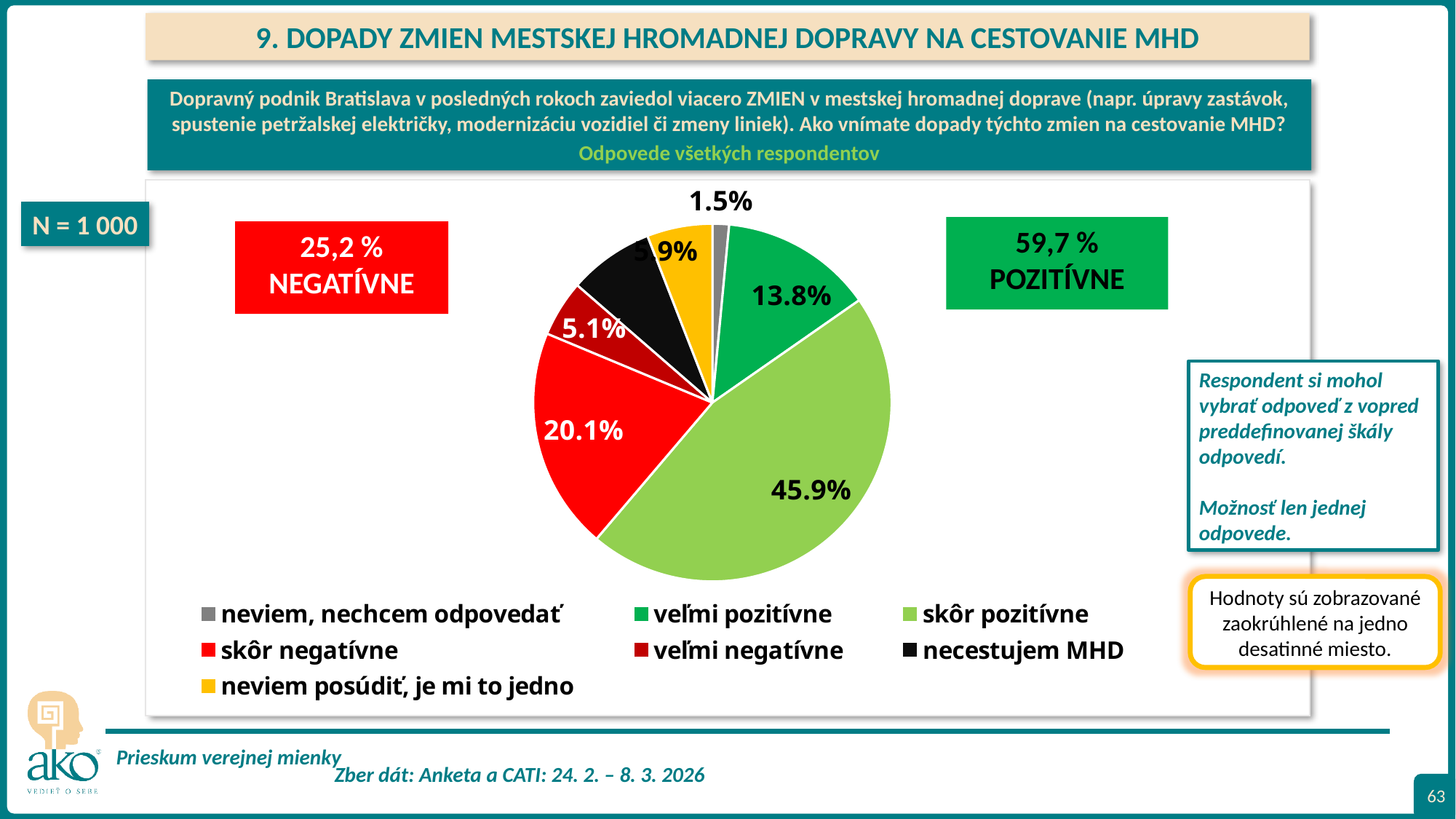
What is the difference in percentage points between "skôr pozitívne" and "skôr negatívne"? 25.8 What is the sample size (N) shown on the slide? N = 1 000 What percentage of respondents answered "skôr pozitívne"? 45.9% Which answer category has the largest share of the pie? skôr pozitívne Which answer category has the smallest share of the pie? neviem, nechcem odpovedať What percentage of respondents answered "veľmi negatívne"? 5.1% Which is larger, the share for "veľmi pozitívne" or the share for "veľmi negatívne"? veľmi pozitívne What percentage of respondents answered "skôr negatívne"? 20.1% How many answer categories does the legend list? 7 What percentage of respondents answered "veľmi pozitívne"? 13.8% What type of chart is shown on the slide? pie chart What percentage of respondents answered "neviem, nechcem odpovedať"? 1.5%